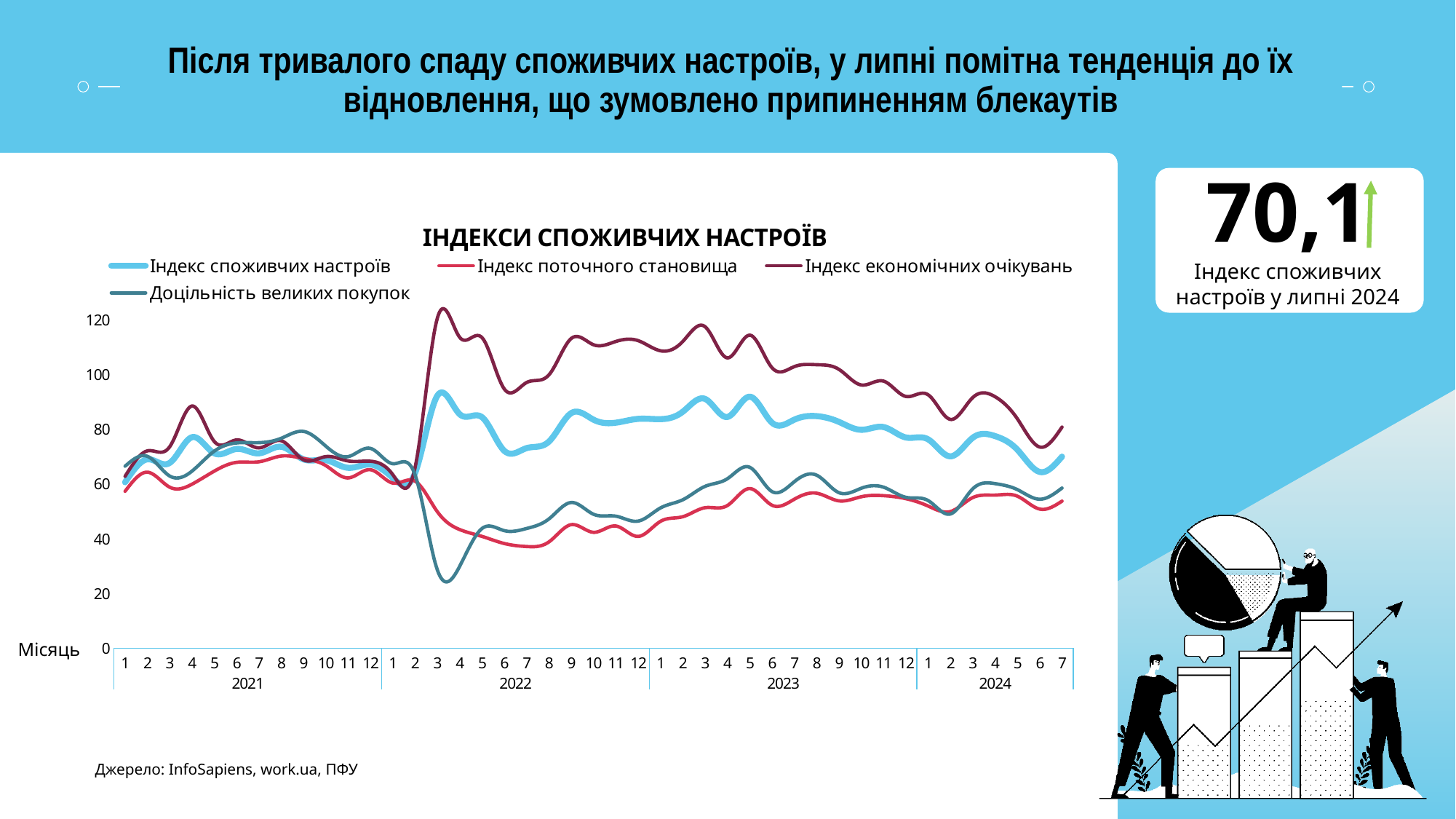
Does Індекс економічних очікувань rise or fall overall from month 1 to month 12 of 2023? fall Is the value of Індекс поточного становища in month 7 of 2022 greater or less than 60? less Is the value of Індекс економічних очікувань in month 3 of 2022 greater or less than 100? greater How many series does the legend of the chart list? 4 Which series has the lowest value in month 3 of 2022? Доцільність великих покупок Is the value of Доцільність великих покупок in month 3 of 2022 greater or less than 40? less What is the title of the chart? ІНДЕКСИ СПОЖИВЧИХ НАСТРОЇВ How many years are shown along the x axis of the chart? 4 What kind of chart is shown on the slide? line chart In month 3 of 2022, which is larger: Індекс економічних очікувань or Доцільність великих покупок? Індекс економічних очікувань Which series has the highest values throughout 2023? Індекс економічних очікувань What is the value of Індекс споживчих настроїв in July 2024? 70,1